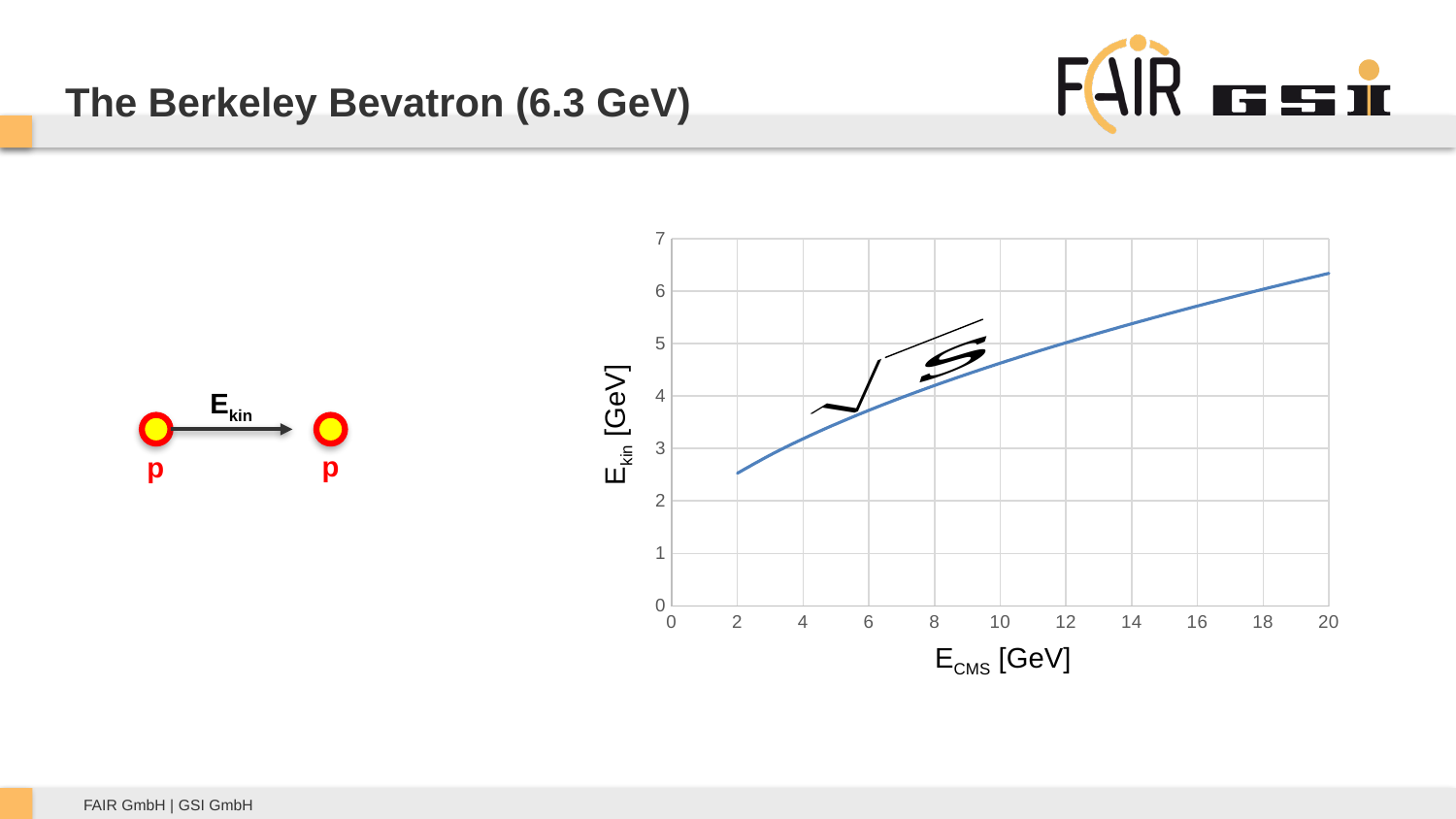
Is the value of E_kin at E_CMS = 10 GeV greater or less than 4? greater Is the value of E_kin at E_CMS = 20 GeV greater or less than 6? greater Is the value of E_kin at E_CMS = 6 GeV greater or less than 4? less What is the label of the y axis of the chart? E_kin [GeV] Does E_kin rise or fall as E_CMS increases along the x axis? rise How many lines are plotted on the chart? 1 What kind of chart is shown on the slide? line chart What is the label of the x axis of the chart? E_CMS [GeV]